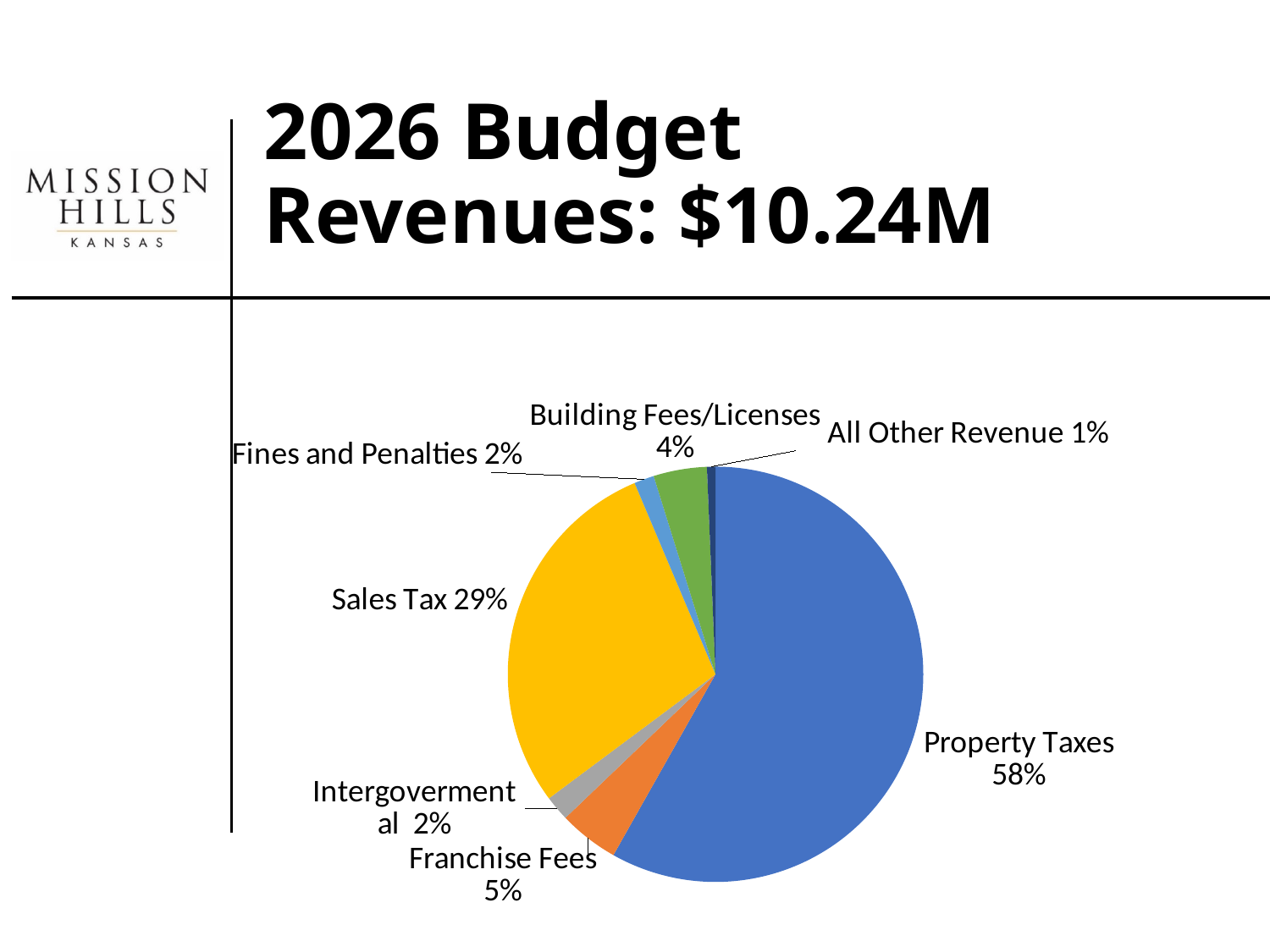
What share of revenues comes from Sales Tax? 29% What percentage is shown for Building Fees/Licenses? 4% What percentage is shown for All Other Revenue? 1% How many percentage points larger is the Property Taxes share than the Sales Tax share? 29 Which revenue category has the smallest share of the pie? All Other Revenue What kind of chart is shown on the slide? pie chart What total revenue amount is stated in the slide title? $10.24M Which revenue category has the largest share of the pie? Property Taxes What share of revenues comes from Property Taxes? 58% What percentage is shown for Franchise Fees? 5% Which is larger, the share for Franchise Fees or the share for Building Fees/Licenses? Franchise Fees How many revenue categories are shown in the pie chart? 7